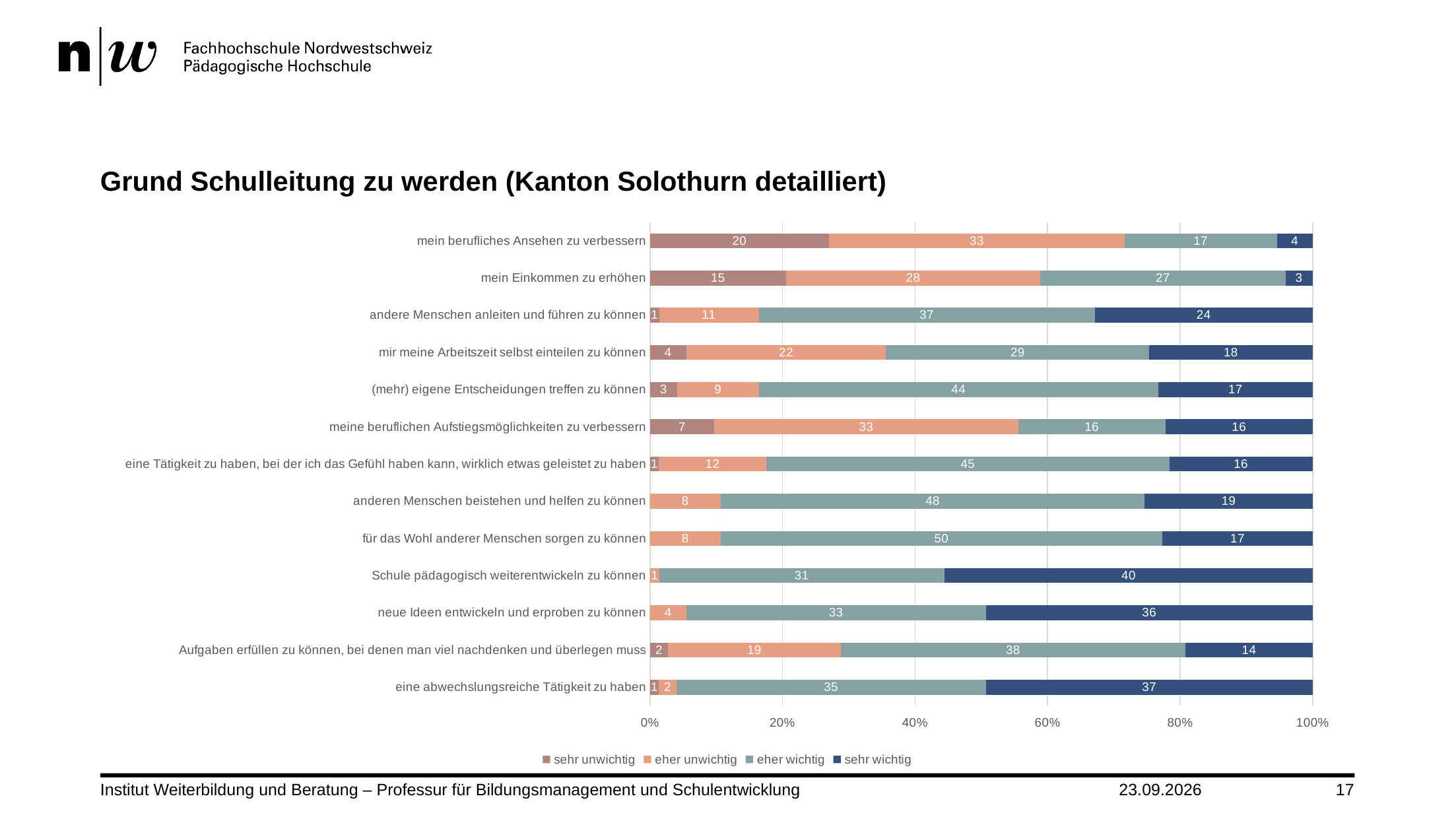
What kind of chart is shown on the slide? stacked bar chart What is the title of the chart? Grund Schulleitung zu werden (Kanton Solothurn detailliert) What is the 'eher unwichtig' value for 'mein berufliches Ansehen zu verbessern'? 33 Which category has the highest 'sehr unwichtig' value? mein berufliches Ansehen zu verbessern What is the 'sehr wichtig' value for 'Schule pädagogisch weiterentwickeln zu können'? 40 Which category has the highest 'sehr wichtig' value? Schule pädagogisch weiterentwickeln zu können What is the total of all segments in the bar for 'eine abwechslungsreiche Tätigkeit zu haben'? 75 What is the difference between the 'sehr wichtig' values for 'neue Ideen entwickeln und erproben zu können' and 'mein Einkommen zu erhöhen'? 33 Which is larger: the 'eher wichtig' value for 'anderen Menschen beistehen und helfen zu können' or for 'mir meine Arbeitszeit selbst einteilen zu können'? anderen Menschen beistehen und helfen zu können What is the 'eher wichtig' value for 'für das Wohl anderer Menschen sorgen zu können'? 50 How many categories (reasons) are plotted in the chart? 13 How many series does the legend list? 4